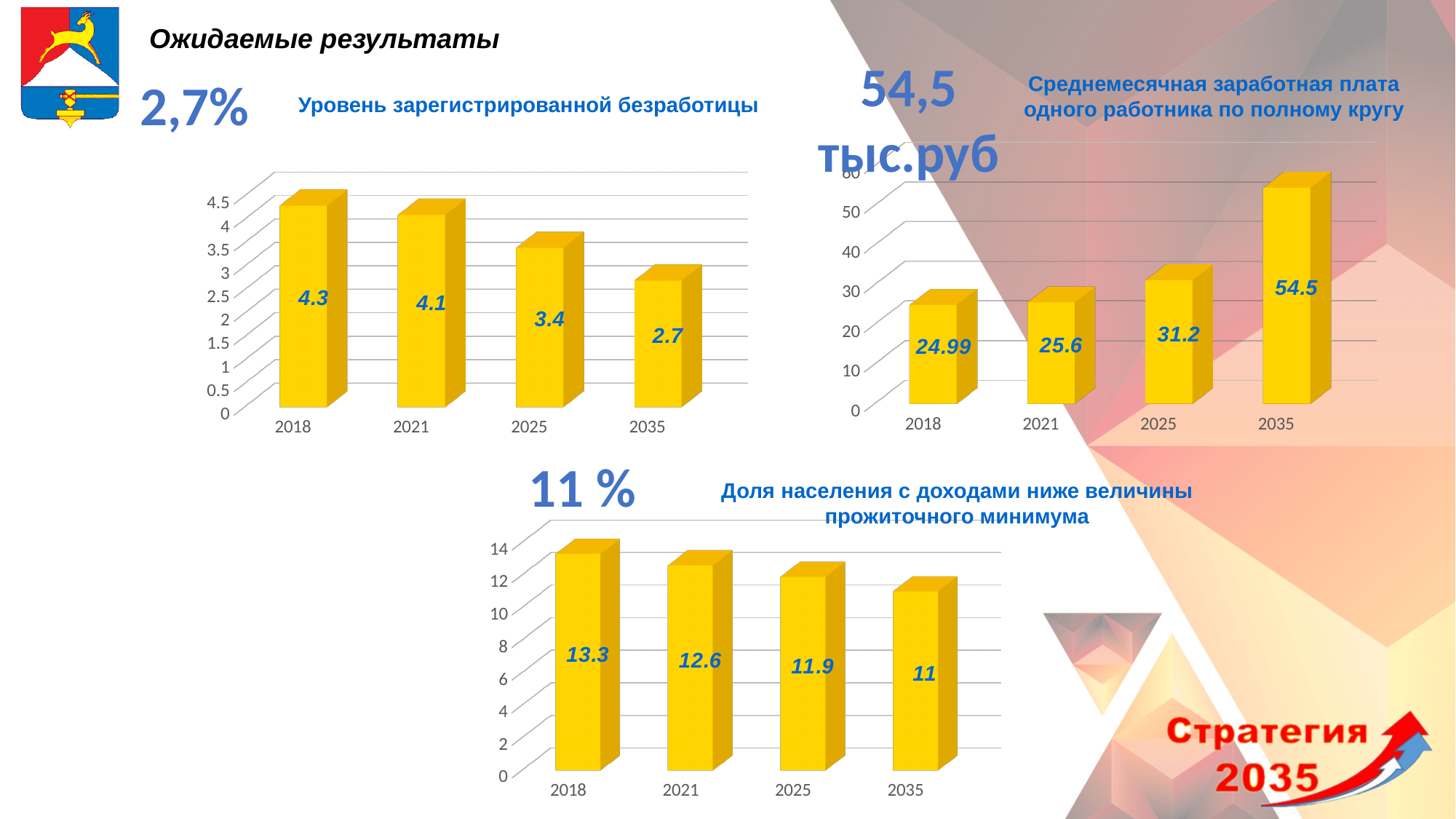
What kind of chart is 'Уровень зарегистрированной безработицы'? bar chart In the chart 'Уровень зарегистрированной безработицы', what is the value for 2025? 3.4 In the chart 'Среднемесячная заработная плата одного работника по полному кругу', which is larger, the value for 2025 or the value for 2035? 2035 In the chart 'Уровень зарегистрированной безработицы', what is the difference between the 2018 and 2035 values? 1.6 How many years are shown on the x axis of the chart 'Доля населения с доходами ниже величины прожиточного минимума'? 4 In the chart 'Доля населения с доходами ниже величины прожиточного минимума', what is the value for 2021? 12.6 In the chart 'Доля населения с доходами ниже величины прожиточного минимума', which year has the lowest value? 2035 In the chart 'Уровень зарегистрированной безработицы', which year has the highest value? 2018 In the chart 'Уровень зарегистрированной безработицы', do the values rise or fall from 2018 to 2035? fall In the chart 'Среднемесячная заработная плата одного работника по полному кругу', what is the value for 2018? 24.99 In the chart 'Среднемесячная заработная плата одного работника по полному кругу', what is the difference between the 2035 and 2025 values? 23.3 In the chart 'Среднемесячная заработная плата одного работника по полному кругу', which year has the lowest value? 2018